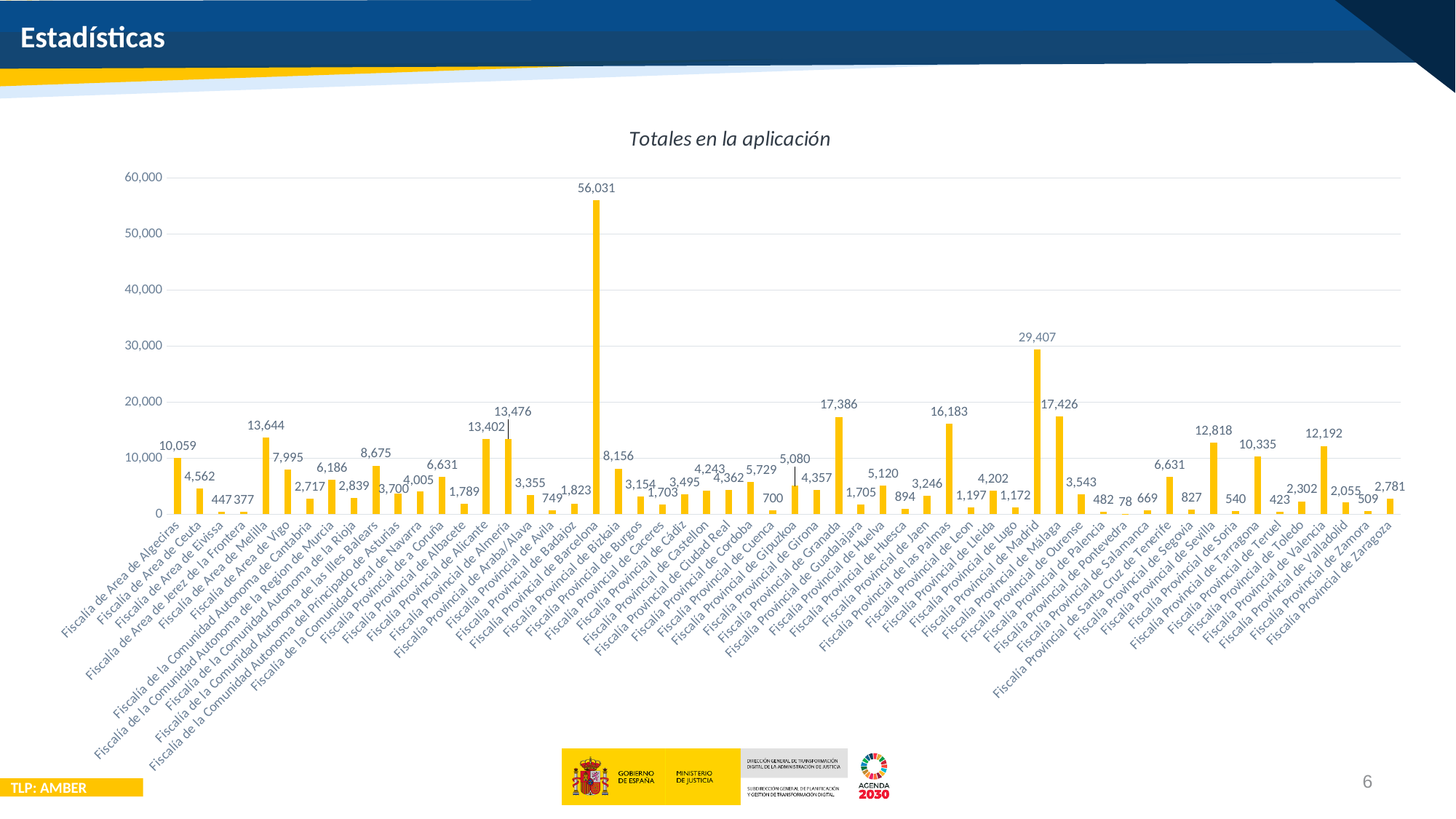
What is the value for Fiscalía Provincial de Barcelona? 56,031 Is the value for Fiscalía Provincial de las Palmas greater or less than 10,000? greater What is the value for Fiscalía de Area de Melilla? 13,644 What kind of chart is shown on the slide? Bar chart What is the title of the chart? Totales en la aplicación What is the value for Fiscalía Provincial de Granada? 17,386 What is the difference between the values for Fiscalía Provincial de Madrid and Fiscalía Provincial de Málaga? 11,981 What is the value for Fiscalía Provincial de Madrid? 29,407 Which category has the highest value in the chart? Fiscalía Provincial de Barcelona Which category has the lowest value in the chart? Fiscalía Provincial de Pontevedra What is the difference between the values for Fiscalía Provincial de Barcelona and Fiscalía Provincial de Madrid? 26,624 Which has a larger value, Fiscalía Provincial de Sevilla or Fiscalía Provincial de Valencia? Fiscalía Provincial de Sevilla